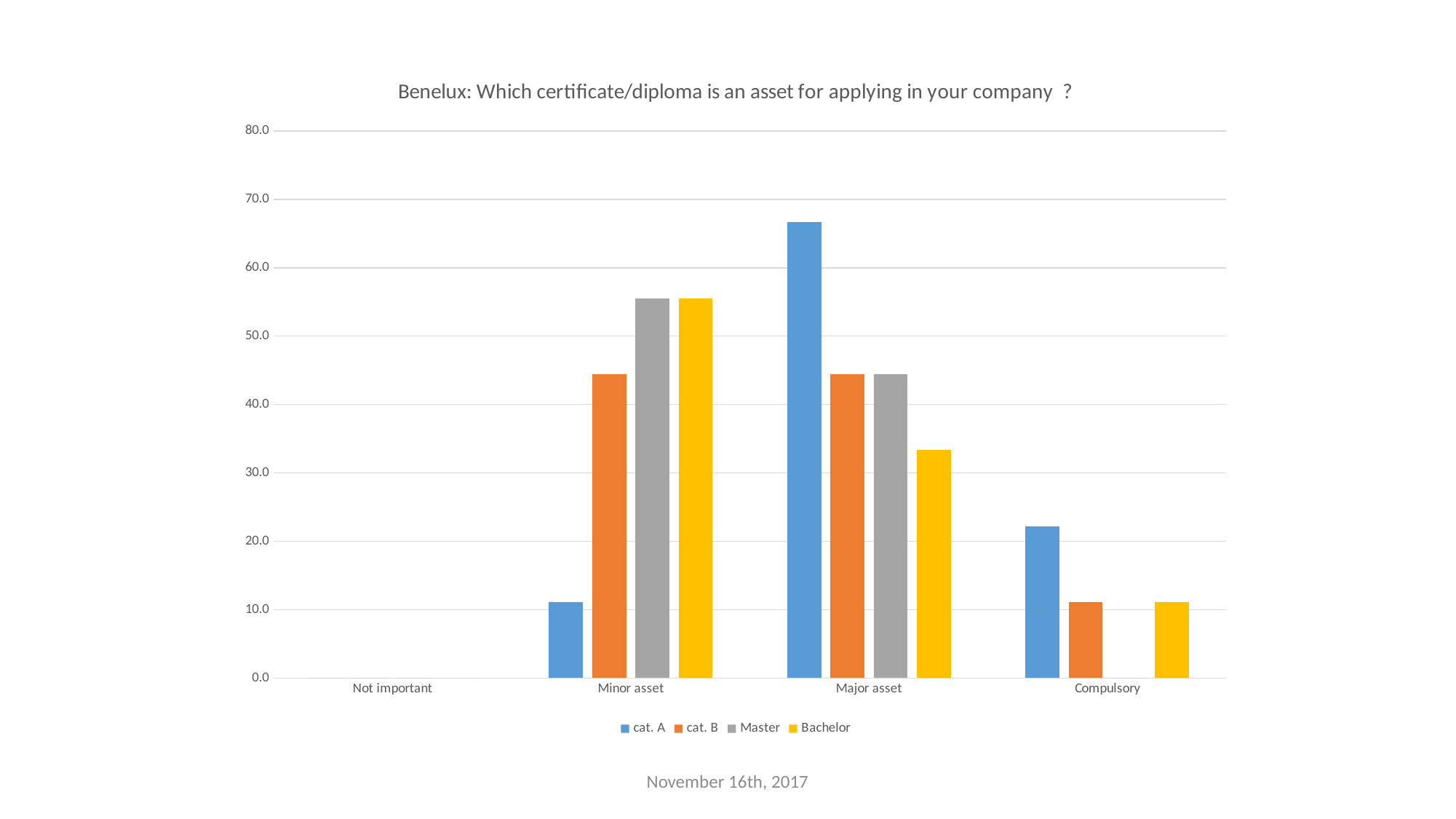
What colour represents the Bachelor series in the legend? yellow What is the title of the chart? Benelux: Which certificate/diploma is an asset for applying in your company ? Is the cat. A value for Compulsory greater or less than 30.0? less How many categories are shown on the x axis? 4 Which category has the highest cat. A value? Major asset How many series does the legend list? 4 Is the Bachelor value for Major asset greater or less than 40.0? less Is the cat. A value for Major asset greater or less than 60.0? greater What kind of chart is shown on the slide? bar chart For Minor asset, which is larger: the Master value or the cat. B value? Master For Major asset, which is larger: the cat. A value or the Bachelor value? cat. A